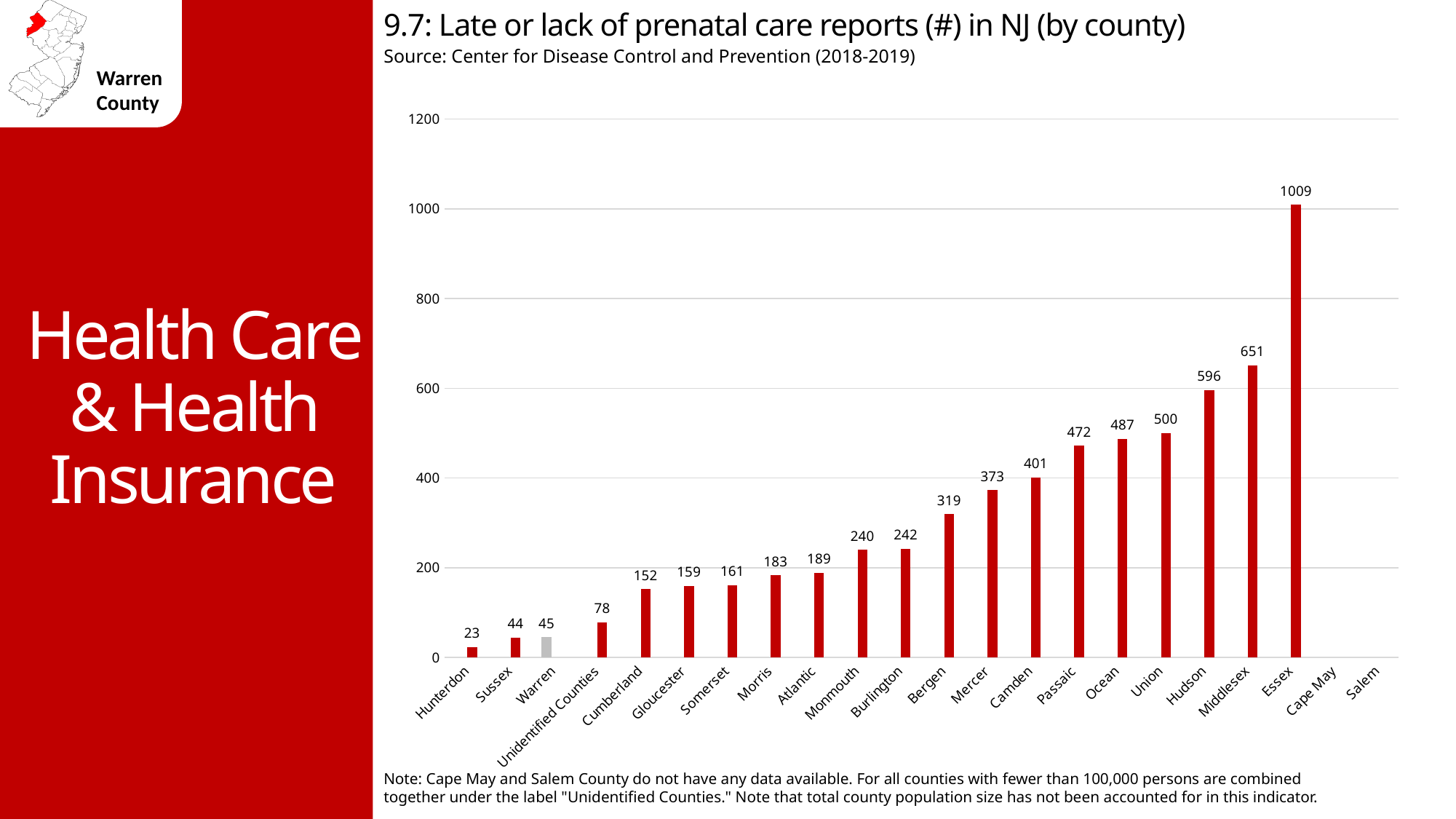
What is the value shown for Essex County? 1009 What is the number of late or lack of prenatal care reports for Warren County? 45 Which bar is coloured grey instead of red? Warren Do the bar values generally rise or fall from Hunterdon to Essex along the x axis? Rise What kind of chart is shown on the slide? Bar chart Which county has the highest number of late or lack of prenatal care reports? Essex Is the value for Bergen greater or less than 400? less What is the value shown for Unidentified Counties? 78 Which county has the lowest number of late or lack of prenatal care reports among those with data? Hunterdon Which has a larger value, Hudson or Union? Hudson How many county labels are shown on the x axis? 22 What is the difference between the values for Essex and Middlesex? 358